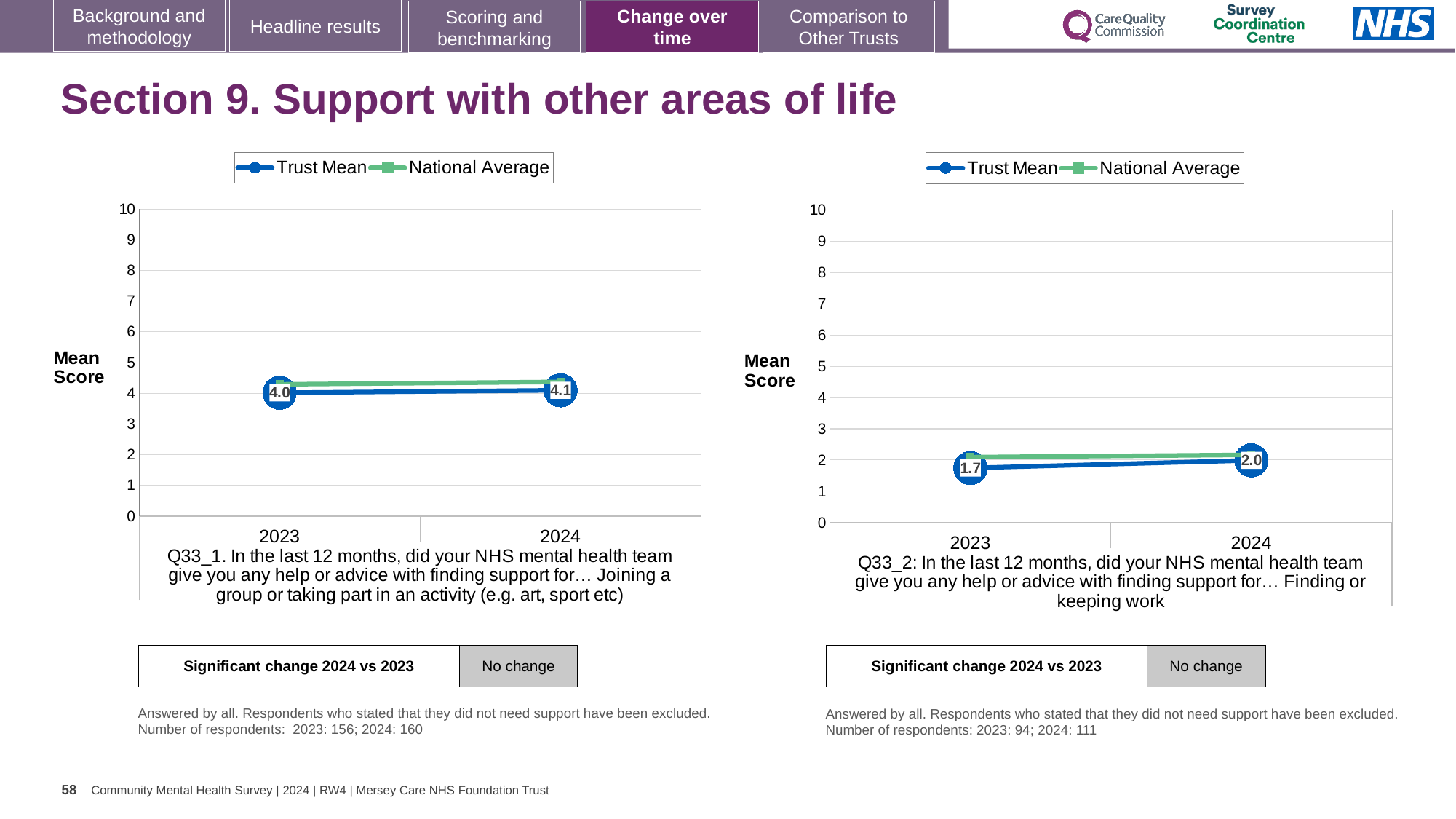
In the right chart (Q33_2), does the Trust Mean rise or fall from 2023 to 2024? rise What does the 'Significant change 2024 vs 2023' box below the left chart (Q33_1) say? No change What kind of chart is the left chart (Q33_1)? line chart In the left chart (Q33_1), what is the Trust Mean score for 2023? 4.0 In the right chart (Q33_2), what is the Trust Mean score for 2023? 1.7 In the left chart (Q33_1), what is the difference between the Trust Mean for 2024 and 2023? 0.1 How many years are plotted on the x axis of the left chart (Q33_1)? 2 How many series does the legend of the right chart (Q33_2) list? 2 In the right chart (Q33_2), is the National Average value for 2024 greater or less than 3? less In the left chart (Q33_1), what is the Trust Mean score for 2024? 4.1 In the right chart (Q33_2), by how much did the Trust Mean change from 2023 to 2024? 0.3 In the right chart (Q33_2), what is the Trust Mean score for 2024? 2.0